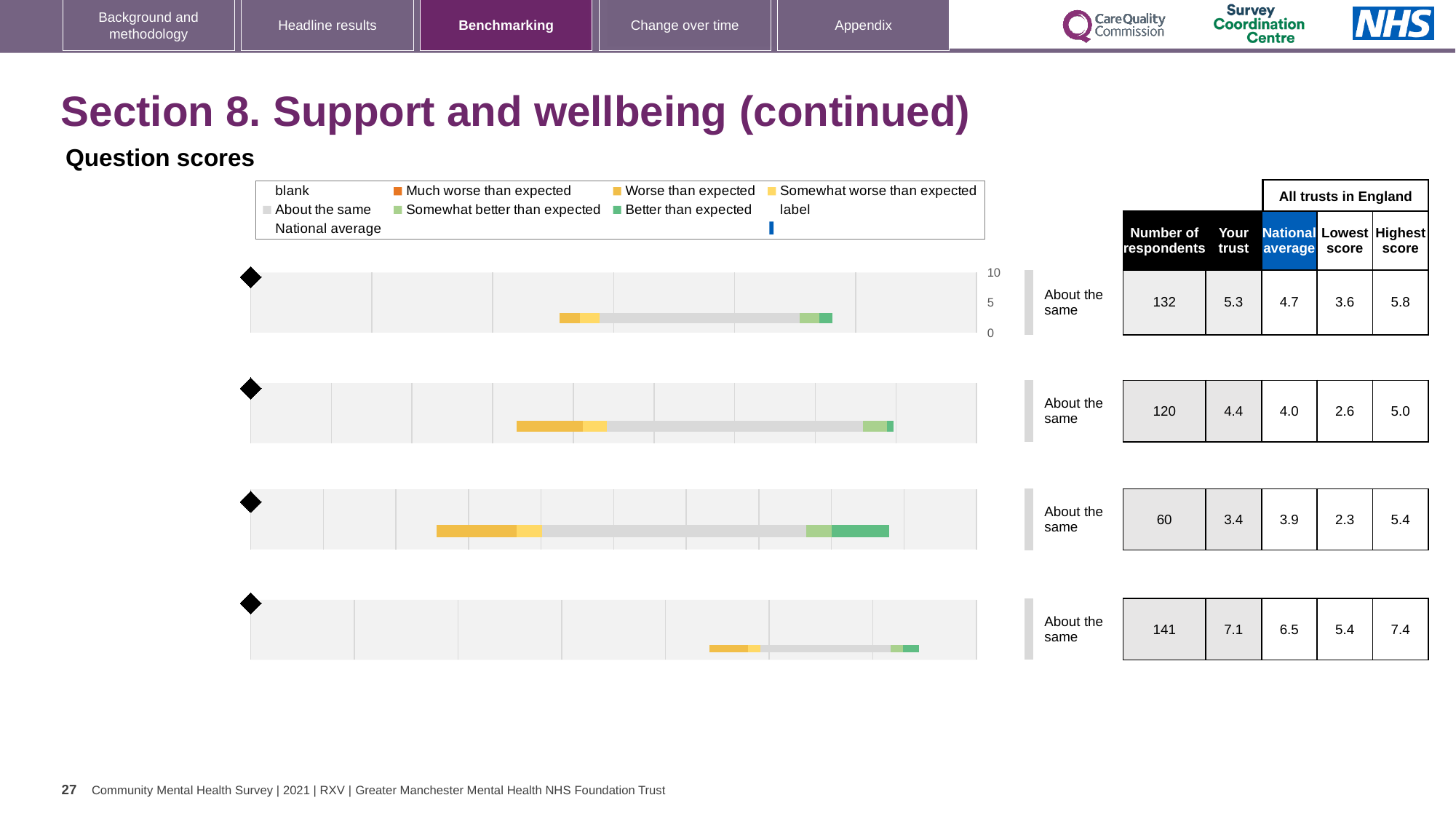
How many categories does the legend above the charts list, excluding 'blank', 'label' and 'National average'? 6 What benchmark label is shown beside each of the four charts? About the same Which chart's row has the highest 'Your trust' score in the table: the first, second, third or fourth from the top? fourth In the legend above the charts, which category is shown in light grey? About the same For the third chart from the top, what is the number of respondents shown in the table beside it? 60 What kind of chart is used for the four benchmarking charts on the slide? bar chart For the first (top) chart, what is the 'Your trust' score shown in the table beside it? 5.3 In the legend above the charts, which category is shown in orange? Much worse than expected For the fourth (bottom) chart, what is the highest score shown in the table beside it? 7.4 For the second chart from the top, what is the national average shown in the table beside it? 4.0 What is the difference between the 'Your trust' score and the national average for the first (top) chart's row? 0.6 How many benchmarking bar charts are shown on the slide? 4